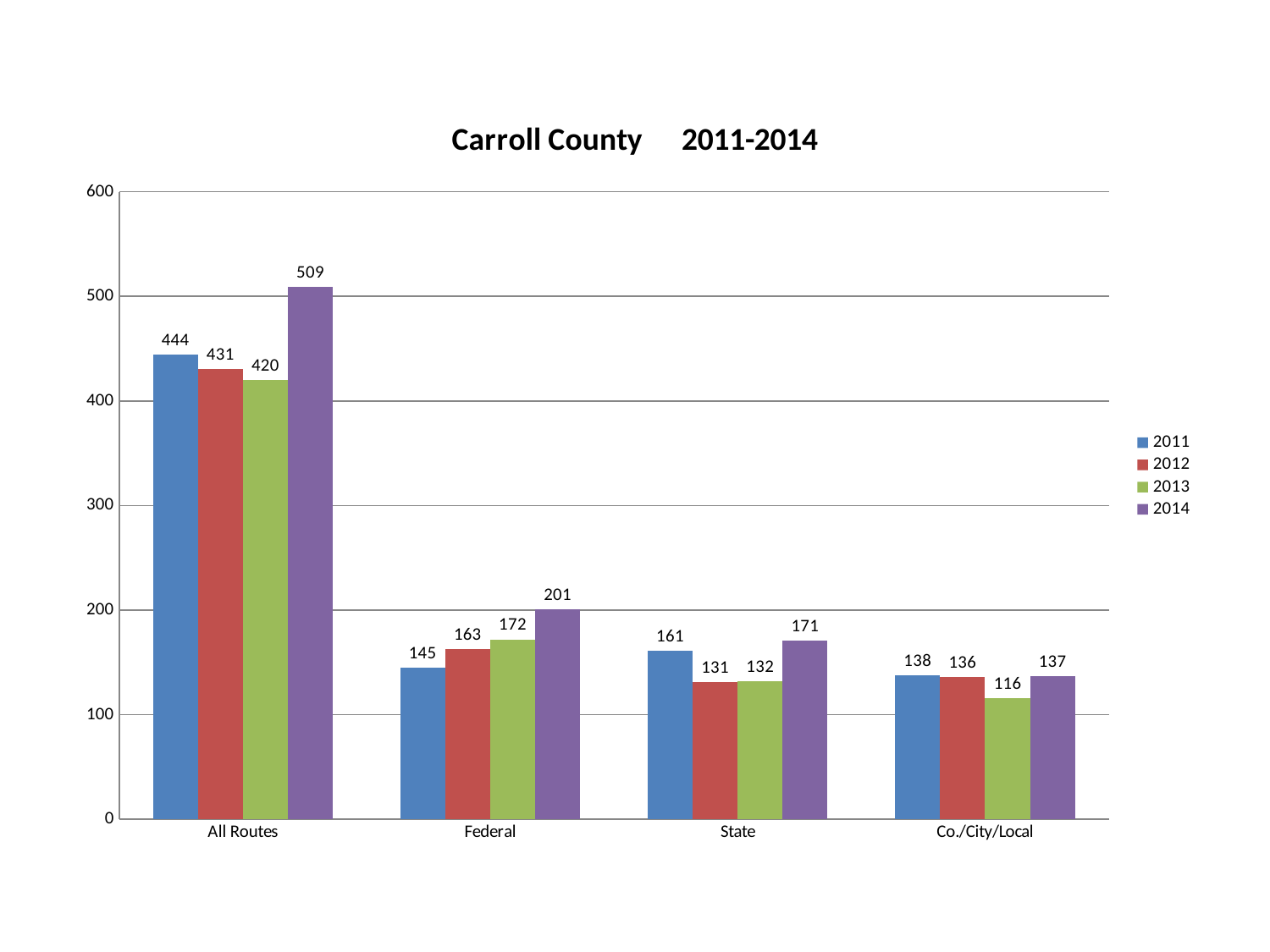
What is the value for Federal in 2011? 145 Which year has the lowest value for State? 2012 Do the values for Federal rise or fall from 2011 to 2014? Rise How many series does the legend list? 4 What is the value for Co./City/Local in 2013? 116 What is the title of the chart? Carroll County 2011-2014 What is the difference between the 2014 and 2011 values for All Routes? 65 Which year has the highest value for All Routes? 2014 Which is larger, the 2013 value for Federal or the 2013 value for State? Federal What kind of chart is shown on the slide? Bar chart How many categories are shown on the x axis? 4 What is the value for All Routes in 2014? 509